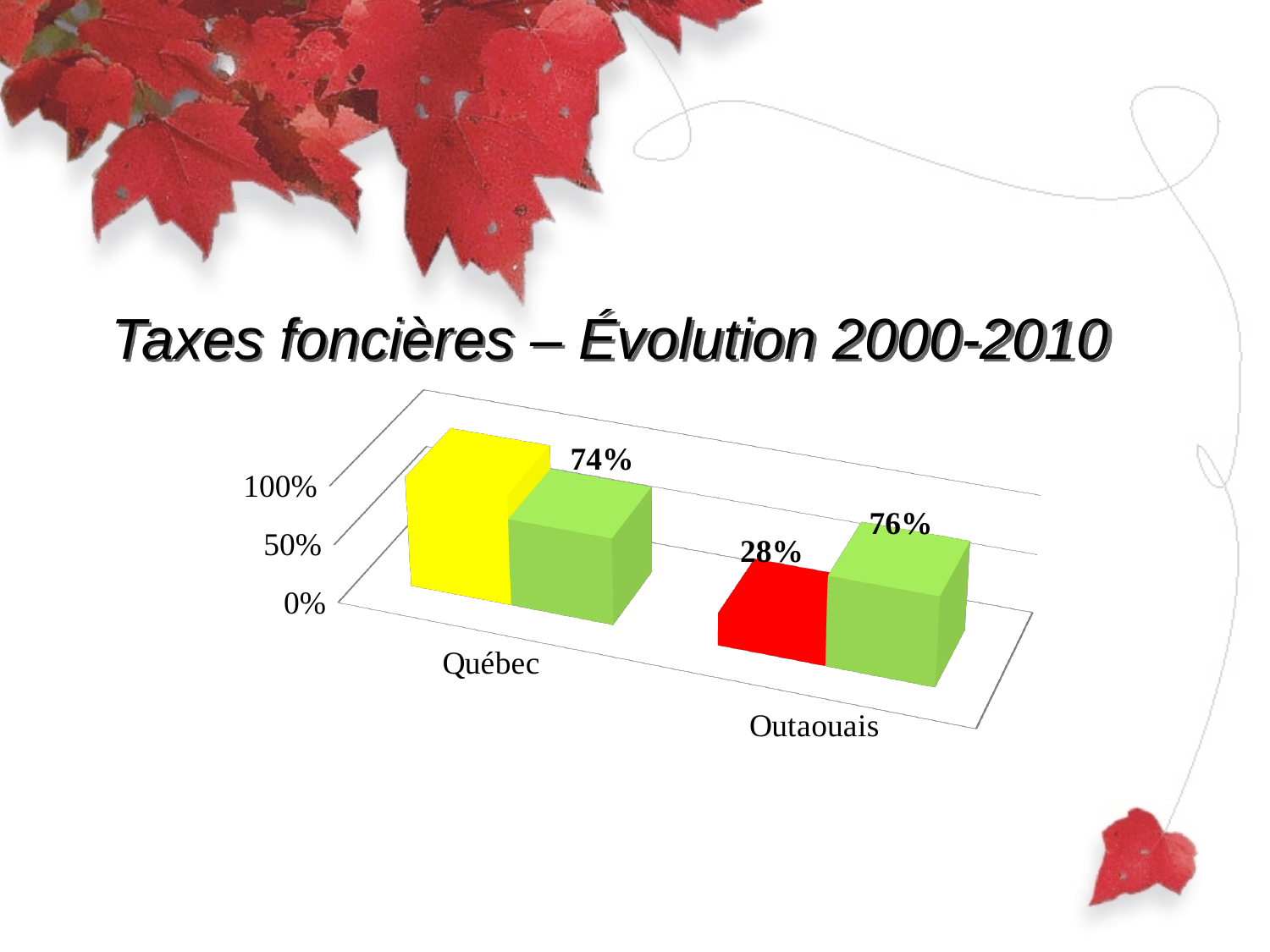
Which labelled value on the chart is the lowest? 28% (Outaouais) What colour is the first bar for Outaouais? red What is the title of the chart on the slide? Taxes foncières – Évolution 2000-2010 Which is larger: the green bar for Outaouais or the green bar for Québec? Outaouais What kind of chart is shown on the slide? bar chart How many categories are shown on the x axis of the chart? 2 What value is labelled on the red bar for Outaouais? 28% What value is labelled on the green bar for Québec? 74% What is the difference between the two labelled values for Outaouais (76% and 28%)? 48 percentage points What is the highest tick value shown on the vertical axis? 100% Is the value of the yellow bar for Québec greater or less than 50%? greater What value is labelled on the green bar for Outaouais? 76%